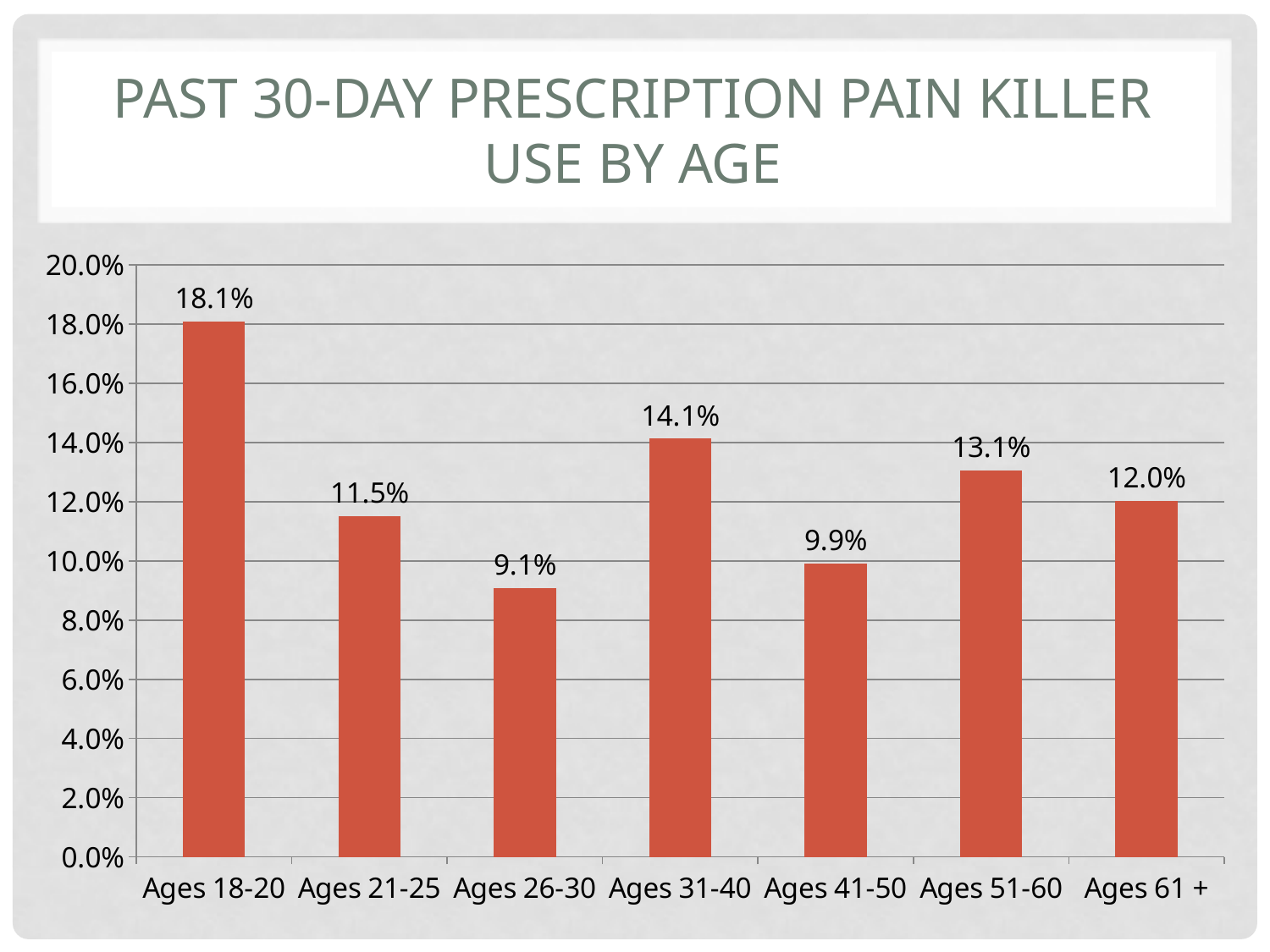
What is the difference between the values for Ages 18-20 and Ages 31-40? 4.0% What is the difference between the values for Ages 51-60 and Ages 61 +? 1.1% What is the past 30-day prescription pain killer use for Ages 18-20? 18.1% What is the title of the chart? Past 30-Day Prescription Pain Killer Use by Age Which is larger, the value for Ages 21-25 or the value for Ages 51-60? Ages 51-60 How many age groups are shown on the chart? 7 Which age group has the highest past 30-day prescription pain killer use? Ages 18-20 What is the value shown for Ages 41-50? 9.9% Which age group has the lowest past 30-day prescription pain killer use? Ages 26-30 What kind of chart is shown on the slide? Bar chart What is the value shown for Ages 61 +? 12.0% Is the value for Ages 31-40 greater or less than 12.0%? greater